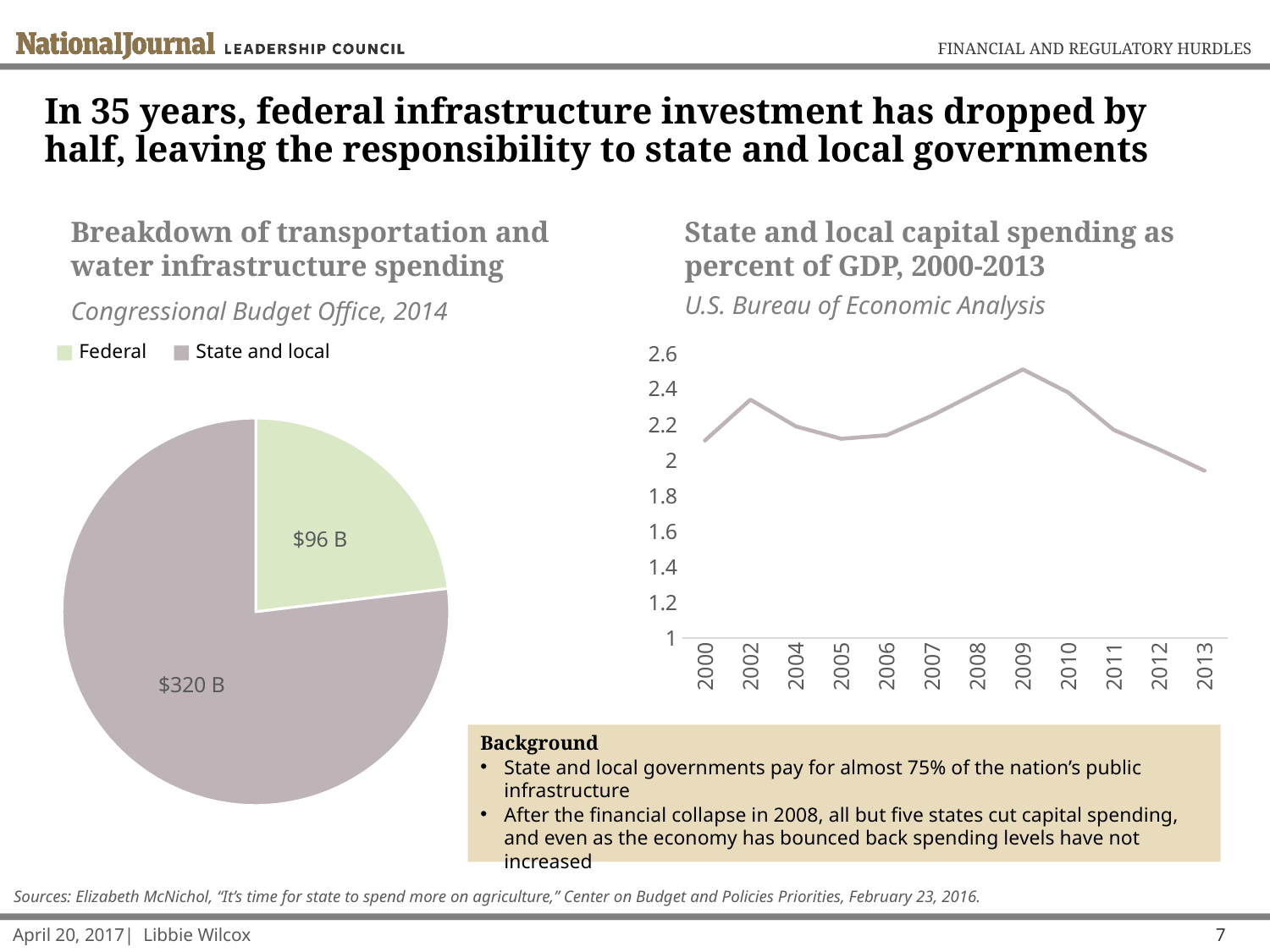
What kind of chart is 'State and local capital spending as percent of GDP, 2000-2013'? Line chart On the pie chart on the left, what is the total of the two slices? $416 B On the pie chart on the left, which category is the largest? State and local On the pie chart on the left, how many categories does the legend list? 2 What kind of chart is the chart on the left of the slide? Pie chart On the line chart 'State and local capital spending as percent of GDP, 2000-2013', which year has the highest value? 2009 On the line chart 'State and local capital spending as percent of GDP, 2000-2013', is the value for 2013 greater or less than 2? less On the line chart 'State and local capital spending as percent of GDP, 2000-2013', which year has the lowest value? 2013 On the pie chart on the left, what is the difference between State and local spending and Federal spending? $224 B On the line chart 'State and local capital spending as percent of GDP, 2000-2013', do values rise or fall from 2009 to 2013? fall On the pie chart 'Breakdown of transportation and water infrastructure spending', what is the value for Federal? $96 B On the pie chart 'Breakdown of transportation and water infrastructure spending', what is the value for State and local? $320 B